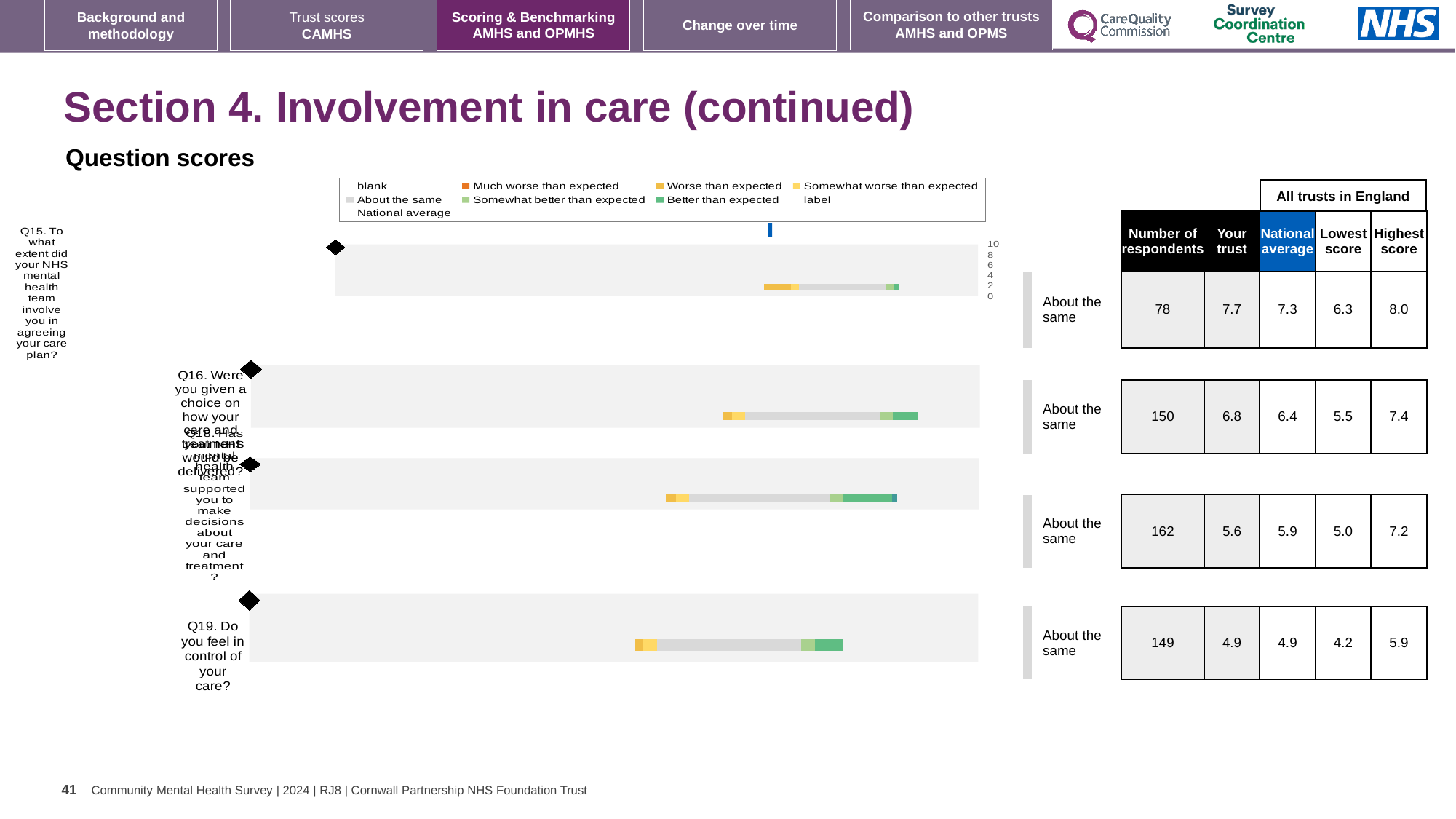
What is the 'Your trust' score for Q15 (To what extent did your NHS mental health team involve you in agreeing your care plan?)? 7.7 Which question has the highest 'Your trust' score? Q15 What is the highest score among all trusts in England for Q19 (Do you feel in control of your care?)? 5.9 What benchmark category is shown for Q19 (Do you feel in control of your care?)? About the same What type of chart is used to show the question scores on this slide? bar chart For Q18, which is larger: the 'Your trust' score or the national average? National average How many questions are plotted in the question scores chart? 4 What is the difference between the 'Your trust' score and the national average for Q15? 0.4 What is the national average score for Q16 (Were you given a choice on how your care and treatment would be delivered?)? 6.4 Which question has the lowest 'Your trust' score? Q19 How many respondents answered Q18 (Has your NHS mental health team supported you to make decisions about your care and treatment?)? 162 What is the lowest score among all trusts in England for Q15? 6.3